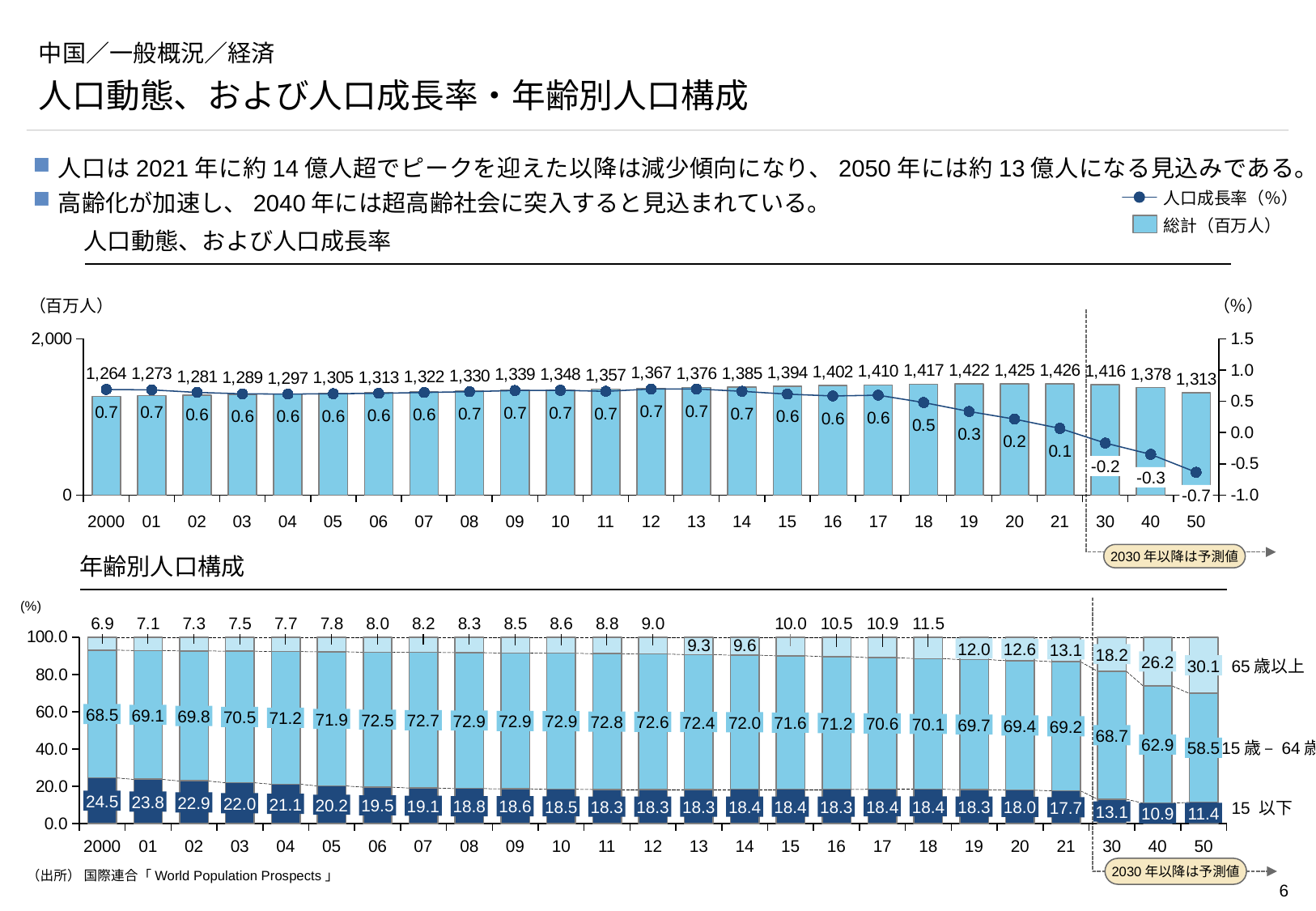
In the 年齢別人口構成 chart, is the share of 15歳－64歳 larger in 2000 or in 2050? 2000 In the 年齢別人口構成 chart, what is the share of 65歳以上 in 2050? 30.1 How many age groups (series) are shown in the 年齢別人口構成 chart? 3 In the 人口動態、および人口成長率 chart, does the population growth rate line rise or fall from 2018 to 2050? fall In the 人口動態、および人口成長率 chart, what is the total population (百万人) shown for 2021? 1,426 How many years are shown on the x axis of the 人口動態、および人口成長率 chart? 25 In the 年齢別人口構成 chart, what is the share of 15 以下 in 2000? 24.5 In the 人口動態、および人口成長率 chart, what is the difference between the total population in 2021 and in 2000? 162 In the 人口動態、および人口成長率 chart, what is the population growth rate (%) shown for 2050? -0.7 What kind of chart is the 人口動態、および人口成長率 chart? Bar chart with a line In the 人口動態、および人口成長率 chart, which year has the highest total population? 2021 In the 人口動態、および人口成長率 chart, which year has the lowest total population? 2000